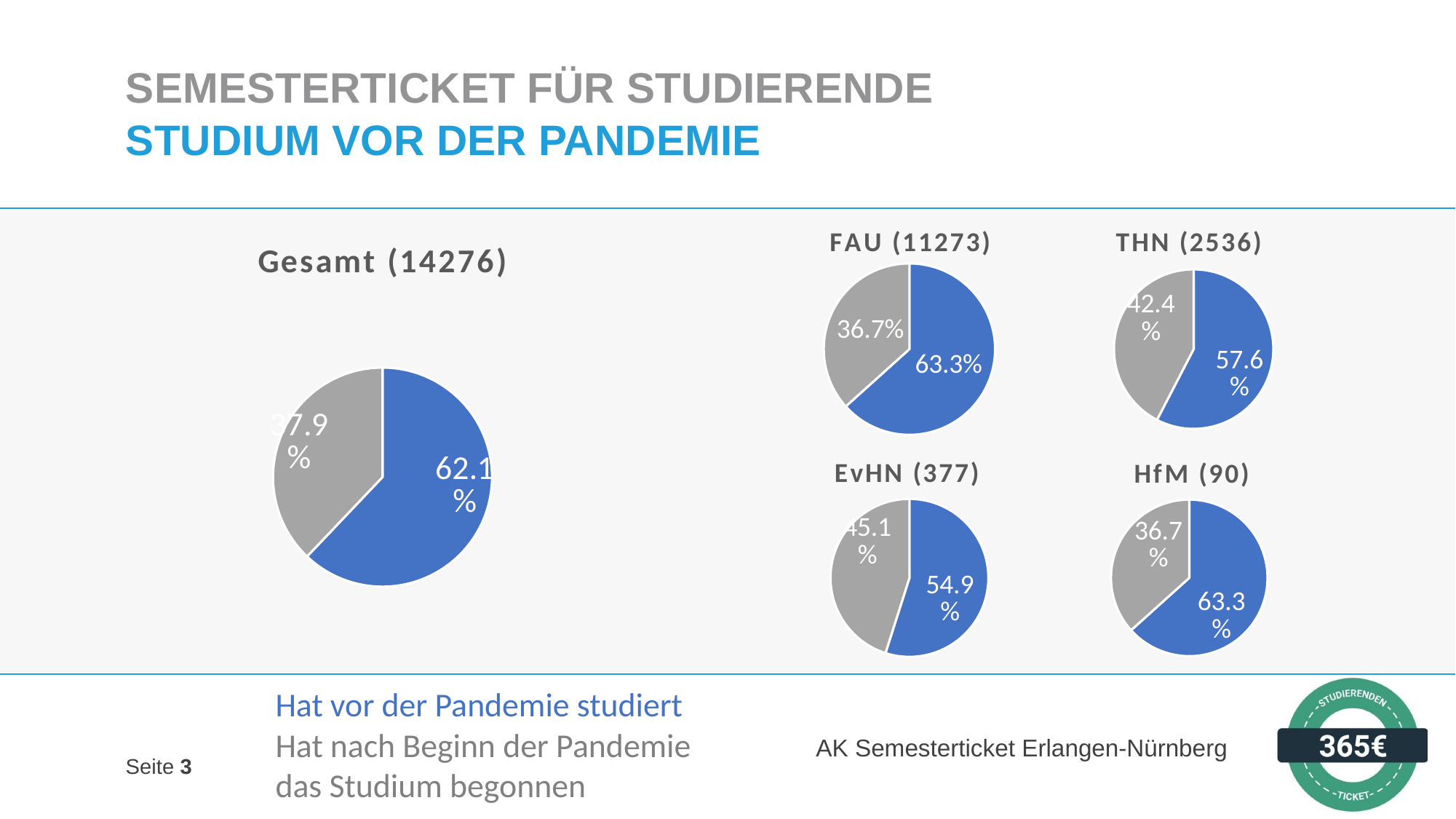
Across the four institution pie charts (FAU, THN, EvHN, HfM), which institution has the lowest share of students who studied before the pandemic? EvHN (377) In the 'THN (2536)' pie chart, what is the value of the grey slice? 42.4% In the 'Gesamt (14276)' pie chart, what share of respondents had studied before the pandemic (blue slice)? 62.1% How many pie charts are shown on the slide? 5 In the 'FAU (11273)' pie chart, what is the value of the blue slice? 63.3% In the 'HfM (90)' pie chart, what is the value of the grey slice? 36.7% According to the legend, what does the blue colour in the pie charts represent? Hat vor der Pandemie studiert In the 'EvHN (377)' pie chart, what share of respondents had studied before the pandemic? 54.9% In the 'Gesamt (14276)' pie chart, what share of respondents began their studies after the start of the pandemic (grey slice)? 37.9% Is the blue slice in the 'FAU (11273)' pie chart larger or smaller than the blue slice in the 'THN (2536)' pie chart? larger In the 'THN (2536)' pie chart, what is the difference between the blue and grey slices? 15.2% What type of chart is used for 'Gesamt (14276)'? pie chart